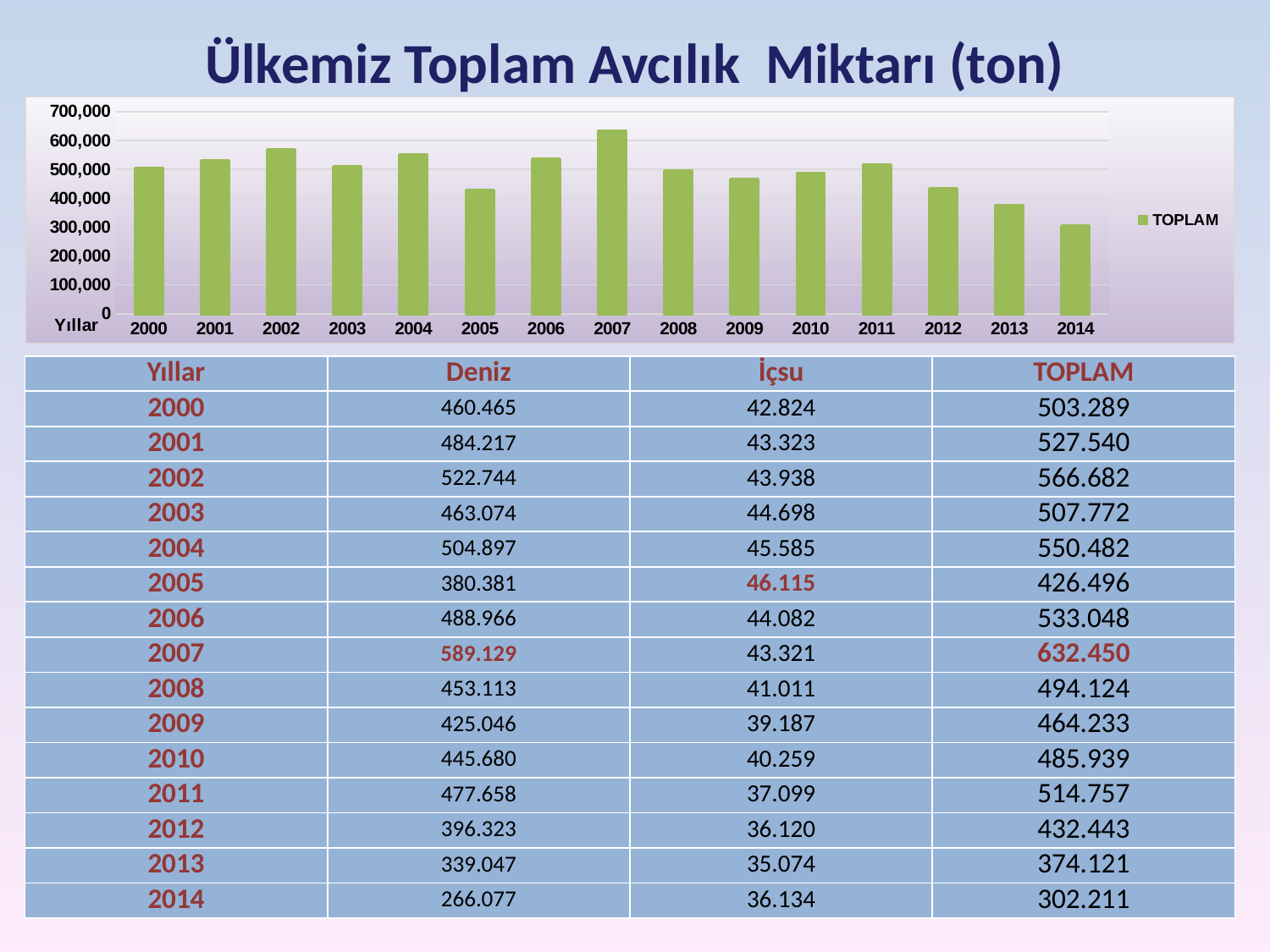
Is the value for 2005 greater or less than 500,000? less Which year has the lowest bar in the chart? 2014 Which year has the highest bar in the chart? 2007 Is the value for 2014 greater or less than 400,000? less Do the bars rise or fall from 2011 to 2014? fall Which year has the larger bar, 2002 or 2003? 2002 What kind of chart is shown on the slide? bar chart According to the table, what is the TOPLAM value for 2007? 632.450 How many series does the chart legend list? 1 Is the value for 2007 greater or less than 600,000? greater How many years are plotted on the x axis of the chart? 15 What is the name of the series shown in the chart legend? TOPLAM